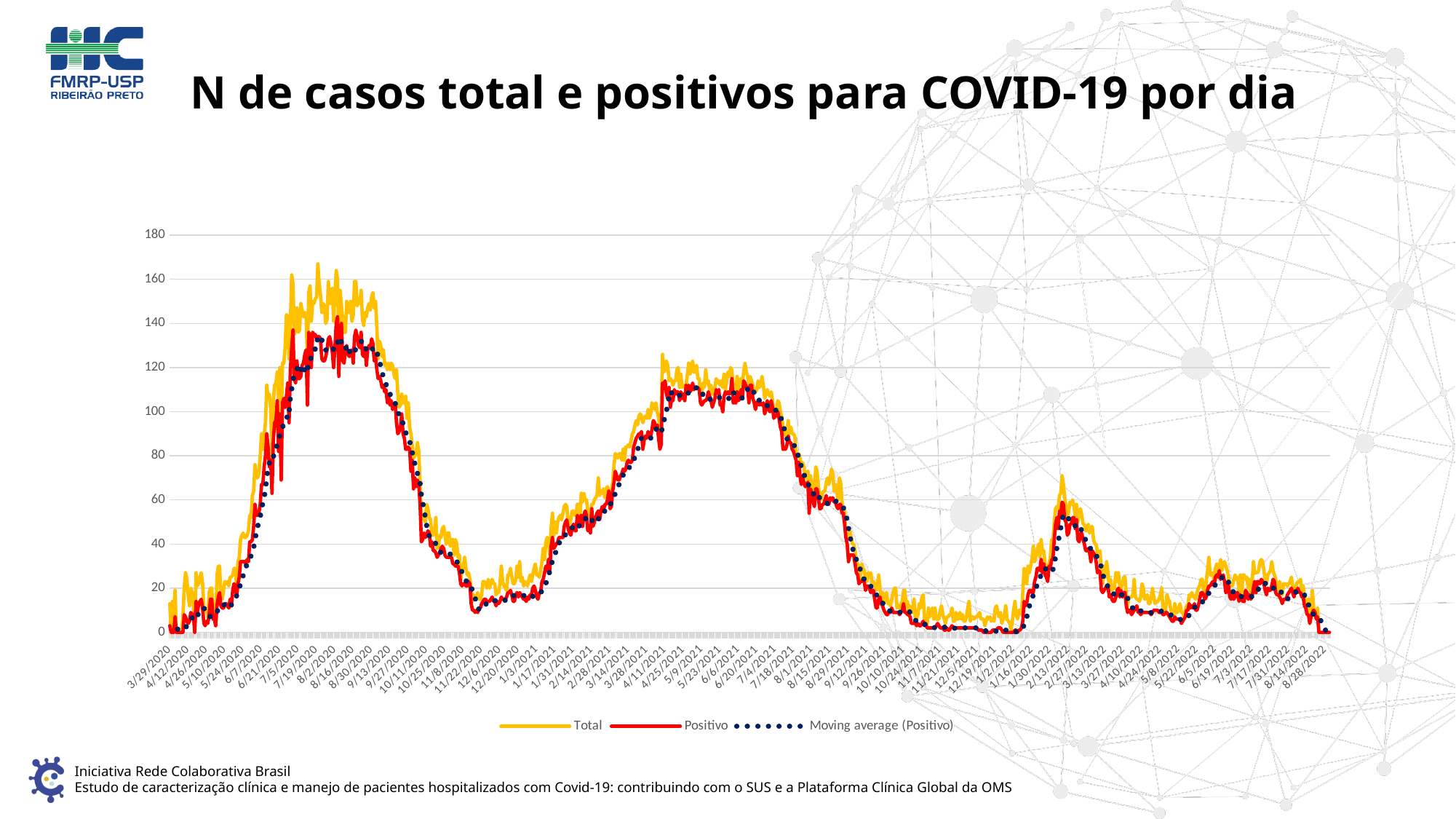
Do the values of the Positivo series rise or fall between 8/16/2020 and 11/22/2020? fall What kind of chart is shown on the slide? line chart Is the value of the Moving average (Positivo) series around 2/13/2022 greater or less than 80? less Which series is drawn as a blue dotted line? Moving average (Positivo) Do the values of the Total series rise or fall between 1/17/2021 and 4/25/2021? rise Which series reaches the highest value on the chart? Total How many series does the legend list? 3 What is the title of the chart? N de casos total e positivos para COVID-19 por dia Around 8/2/2020, which series has the larger value, Total or Positivo? Total Is the peak value of the Total series in July 2020 greater or less than 140? greater Is the value of the Positivo series around 12/19/2021 greater or less than 20? less